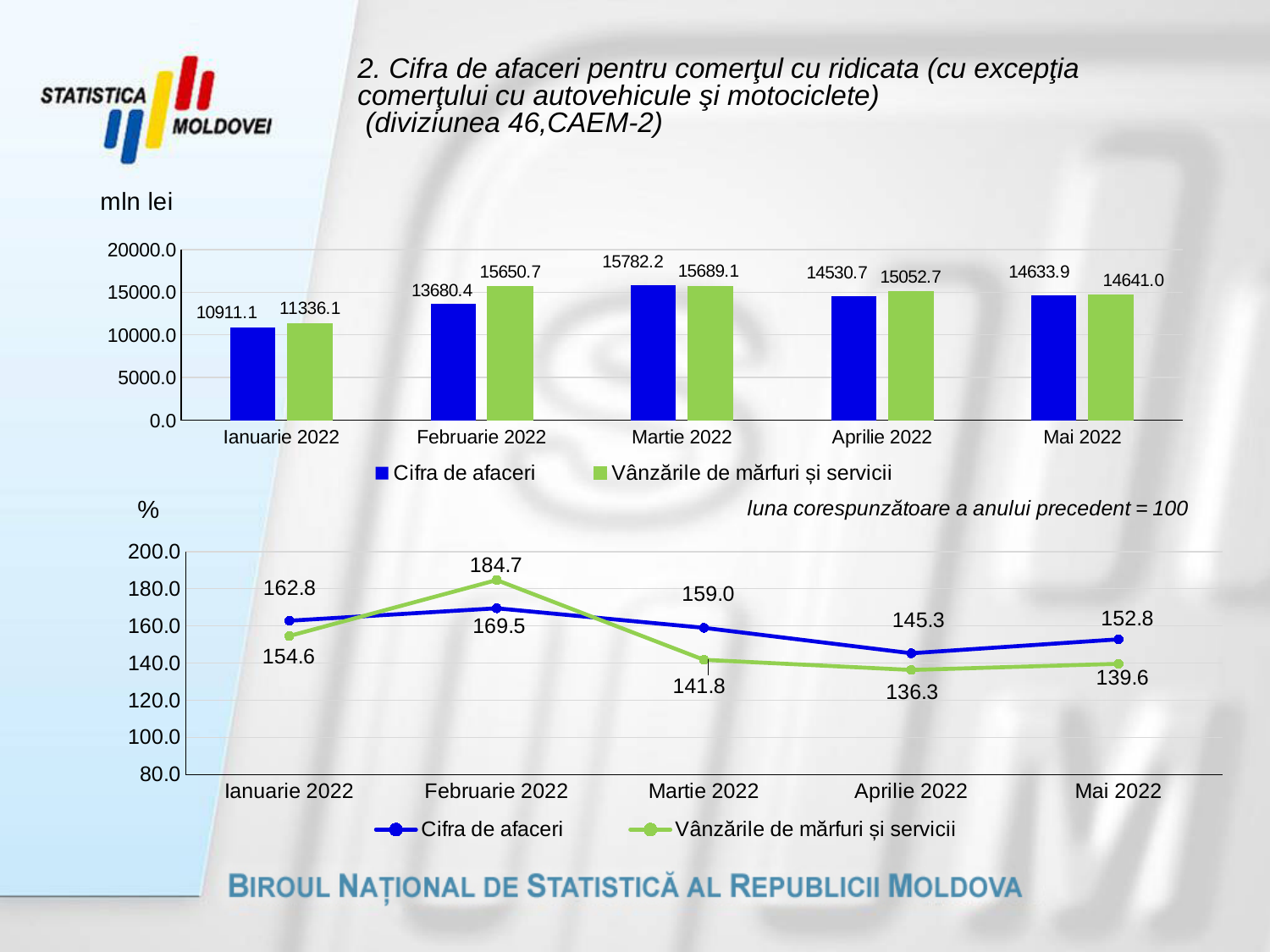
In the bottom line chart (%), what is the value of Cifra de afaceri for Aprilie 2022? 145.3 In the top bar chart (mln lei), how many months are shown on the x axis? 5 In the bottom line chart (%), which is larger in Martie 2022: Cifra de afaceri or Vânzările de mărfuri și servicii? Cifra de afaceri In the top bar chart (mln lei), which month has the highest value for Vânzările de mărfuri și servicii? Martie 2022 In the top bar chart (mln lei), what is the difference between Vânzările de mărfuri și servicii and Cifra de afaceri in Februarie 2022? 1970.3 What type of chart is the top chart (mln lei)? Bar chart In the top bar chart (mln lei), what is the value of Vânzările de mărfuri și servicii for Februarie 2022? 15650.7 In the top bar chart (mln lei), what is the value of Cifra de afaceri for Martie 2022? 15782.2 How many series does the legend of the bottom line chart (%) list? 2 In the top bar chart (mln lei), which month has the lowest value for Cifra de afaceri? Ianuarie 2022 In the bottom line chart (%), what is the value of Vânzările de mărfuri și servicii for Februarie 2022? 184.7 In the bottom line chart (%), which month has the lowest value for Vânzările de mărfuri și servicii? Aprilie 2022